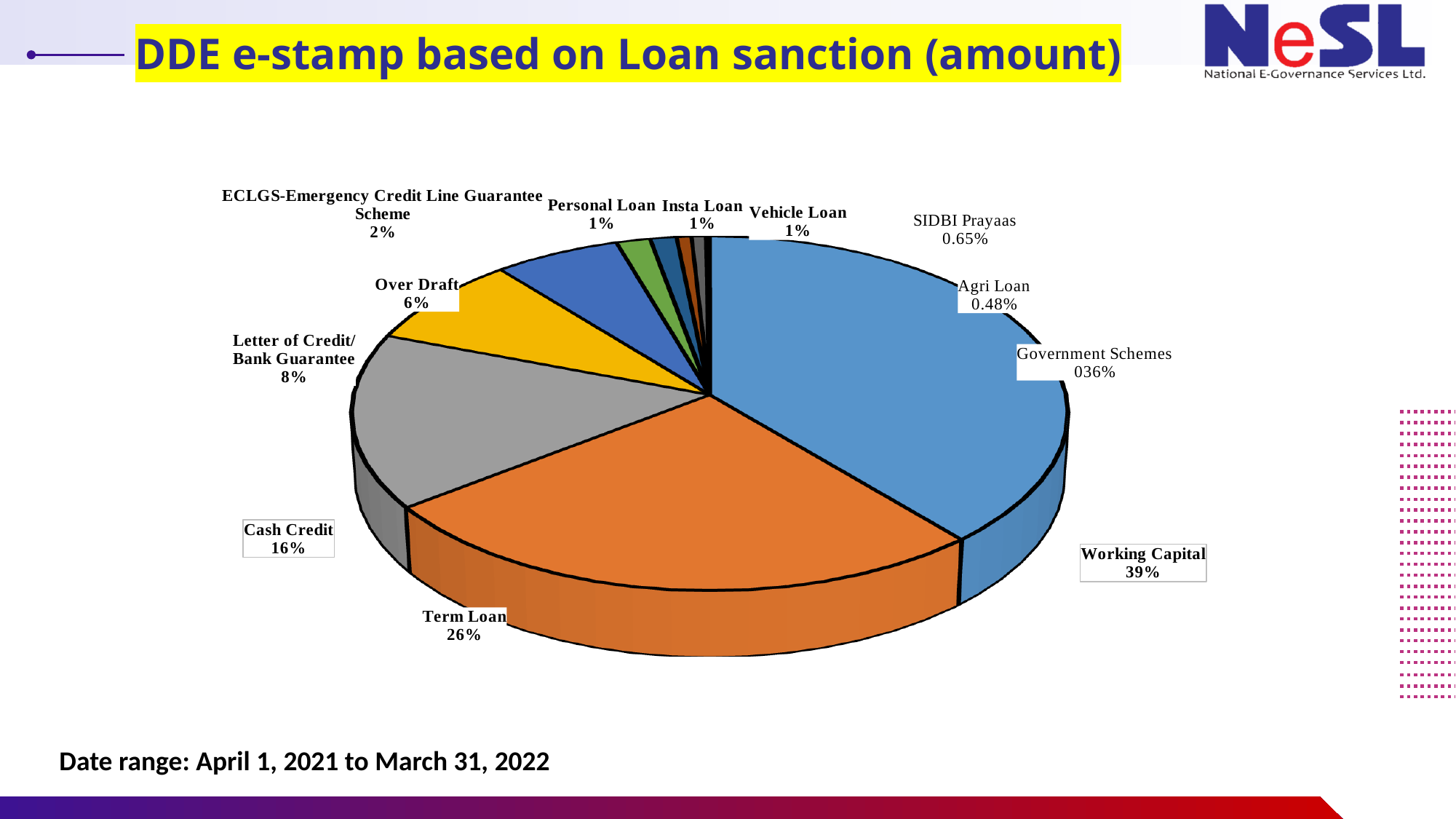
Which is larger, Term Loan or Cash Credit? Term Loan What is the value shown for Agri Loan? 0.48% What is the value shown for Cash Credit? 16% What is the value shown for Letter of Credit/ Bank Guarantee? 8% What date range does the chart cover, according to the slide? April 1, 2021 to March 31, 2022 Which loan category has the largest slice of the pie? Working Capital By how many percentage points does Working Capital exceed Term Loan? 13 percentage points What is the value shown for Over Draft? 6% What is the value shown for Term Loan? 26% What is the value shown for SIDBI Prayaas? 0.65% What kind of chart is shown on the slide? pie chart What share of the pie does Working Capital account for? 39%